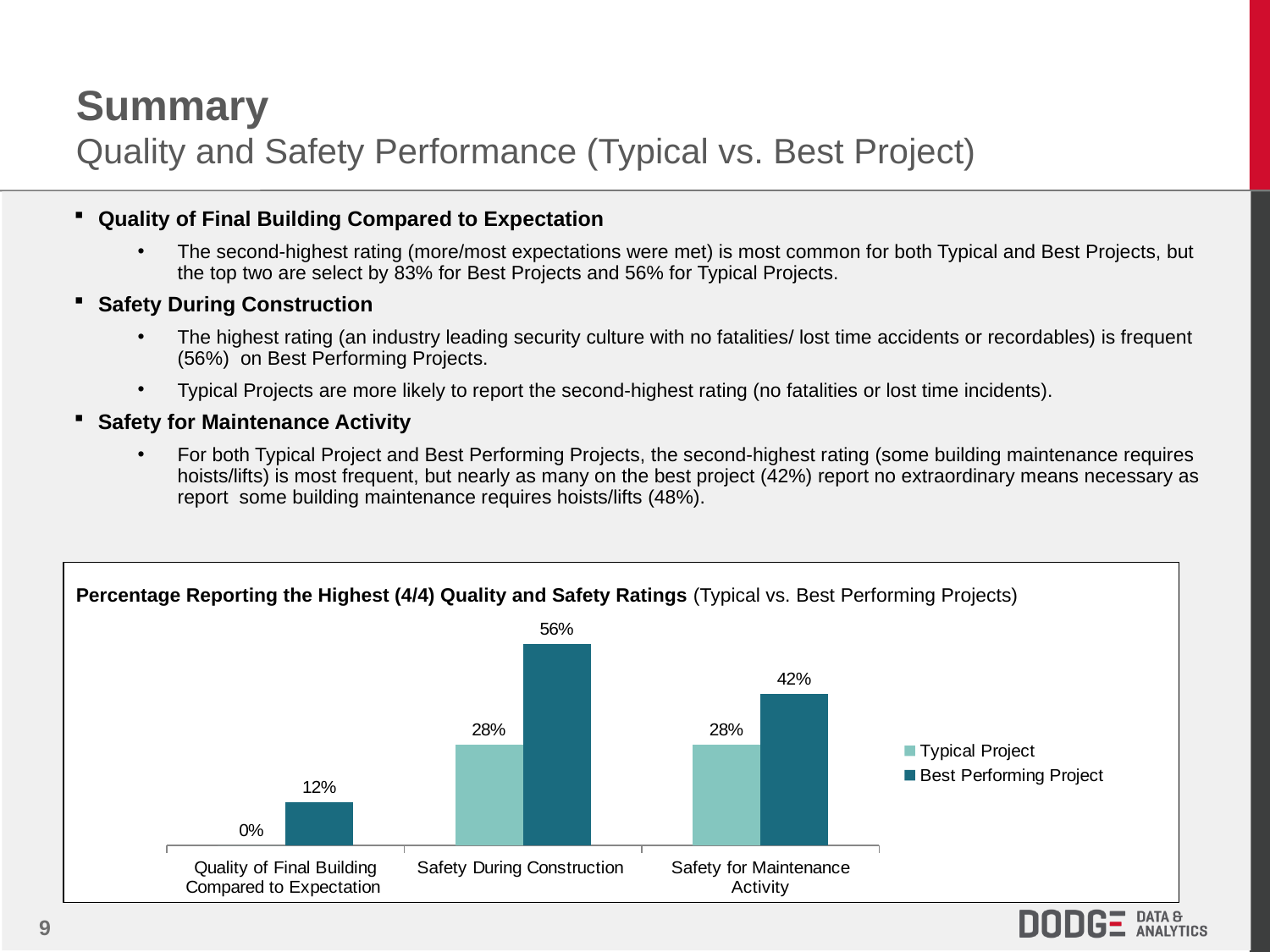
How many categories are shown on the x axis of the chart? 3 Which category has the highest value for Best Performing Project? Safety During Construction What are the two series named in the chart legend? Typical Project and Best Performing Project What is the difference between Best Performing Project and Typical Project for Safety for Maintenance Activity? 14% Which is larger for Quality of Final Building Compared to Expectation: Typical Project or Best Performing Project? Best Performing Project What type of chart is shown on the slide? Bar chart What is the difference between Best Performing Project and Typical Project for Safety During Construction? 28% What is the value for Best Performing Project in the Safety for Maintenance Activity category? 42% How many series does the chart legend list? 2 Which category has the lowest value for Typical Project? Quality of Final Building Compared to Expectation What percentage of Best Performing Projects report the highest rating for Safety During Construction? 56% What is the value for Typical Project in the Quality of Final Building Compared to Expectation category? 0%